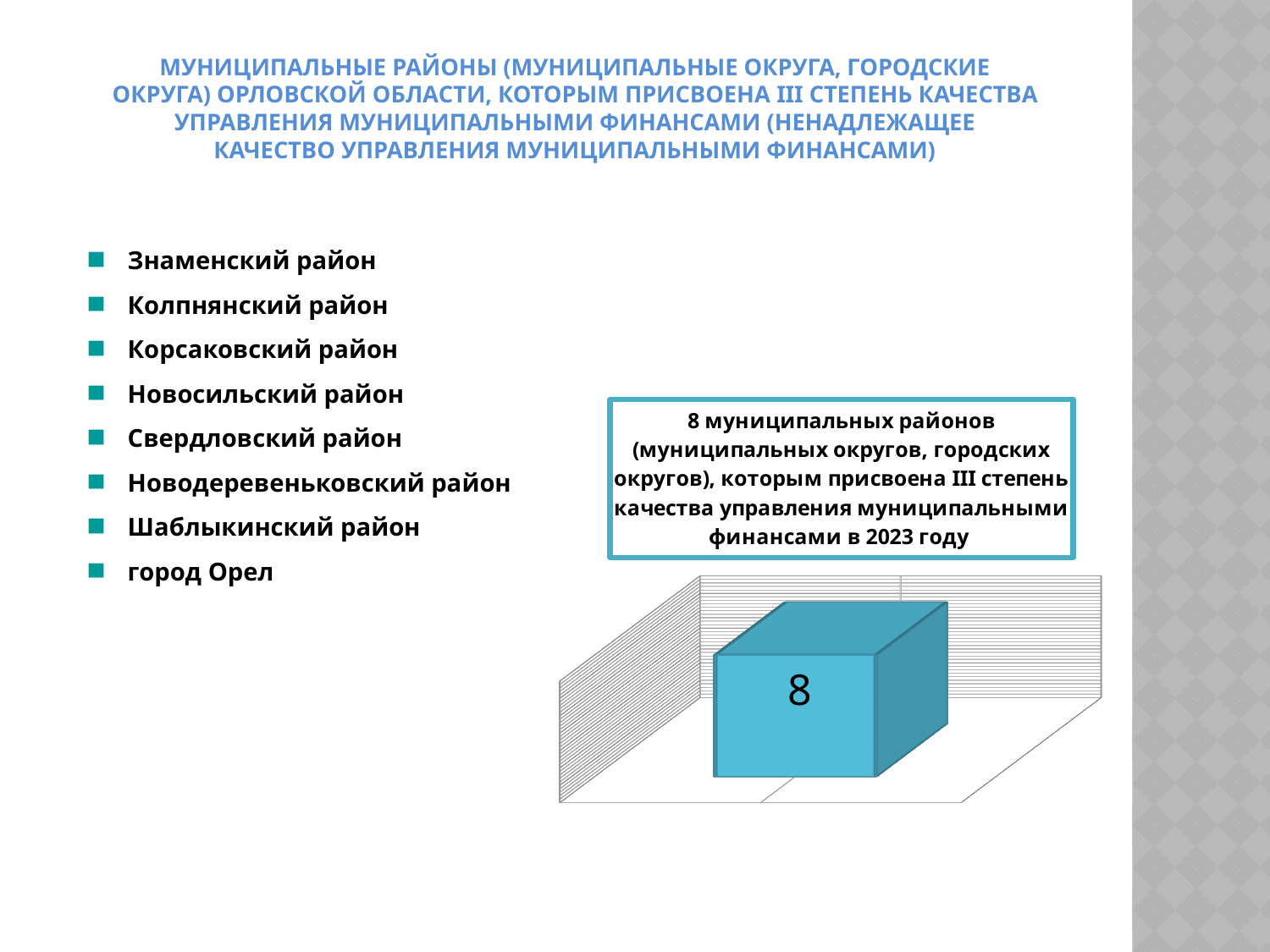
What kind of chart is shown on the slide? bar chart How many bars does the chart show? 1 Is the value shown on the bar greater or less than 5? greater What value is printed on the single bar in the chart? 8 According to the chart's title box, in which year were 8 municipal districts assigned the III degree of quality of municipal finance management? 2023 What colour is the bar in the chart? blue